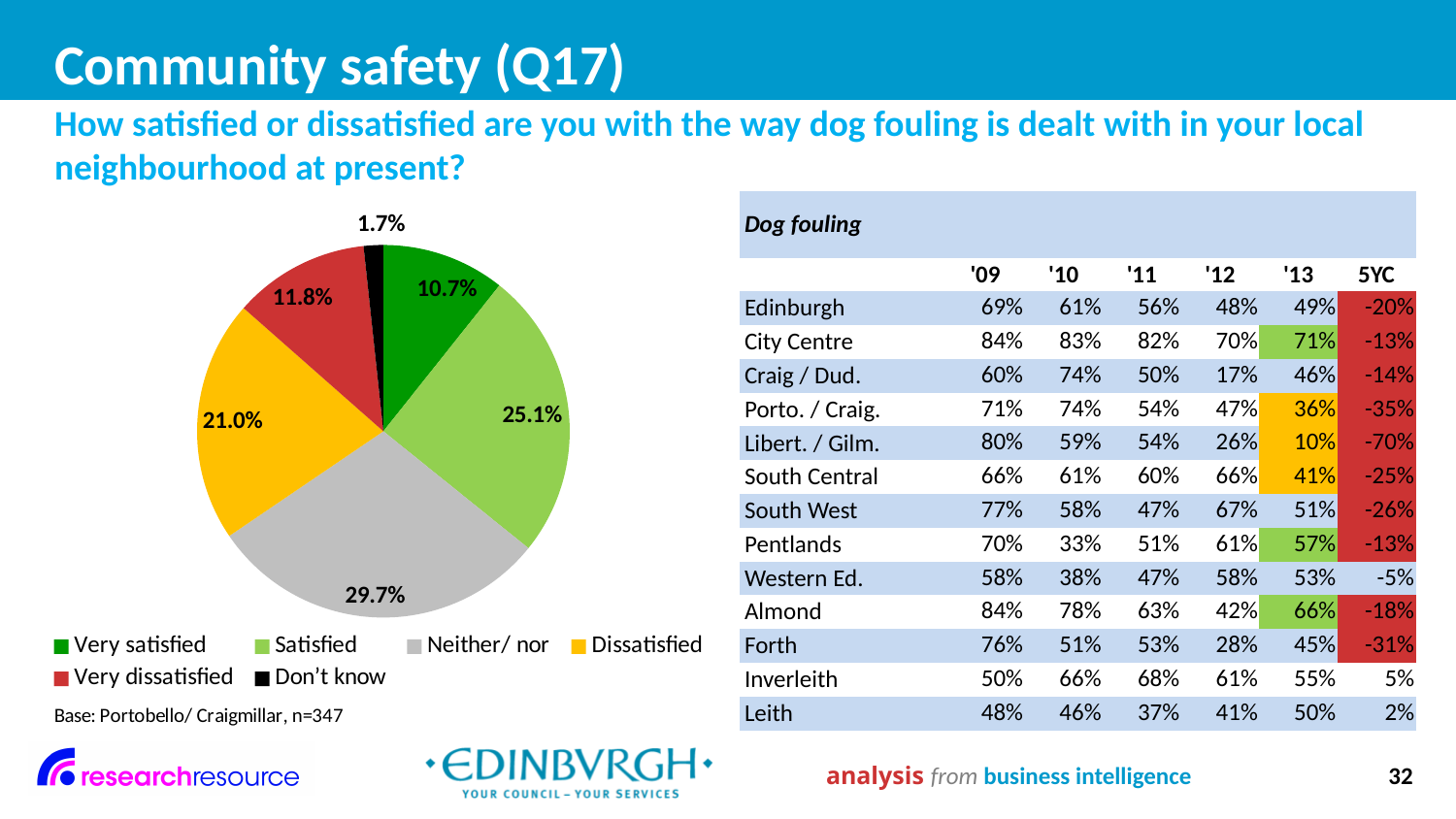
What is the combined share of 'Very satisfied' and 'Satisfied' in the pie chart? 35.8% What colour is the 'Dissatisfied' slice in the pie chart? yellow Which category has the smallest slice in the pie chart? Don't know How many categories does the pie chart legend list? 6 Which category has the largest slice in the pie chart? Neither/ nor What kind of chart is shown on the slide? pie chart What percentage of respondents answered 'Neither/ nor' in the pie chart? 29.7% What percentage of respondents answered 'Don't know' in the pie chart? 1.7% What percentage of respondents are 'Satisfied' in the pie chart? 25.1% What percentage of respondents are 'Very dissatisfied' in the pie chart? 11.8% What is the difference between the 'Satisfied' and 'Very satisfied' percentages in the pie chart? 14.4% Which is larger in the pie chart: 'Dissatisfied' or 'Very dissatisfied'? Dissatisfied